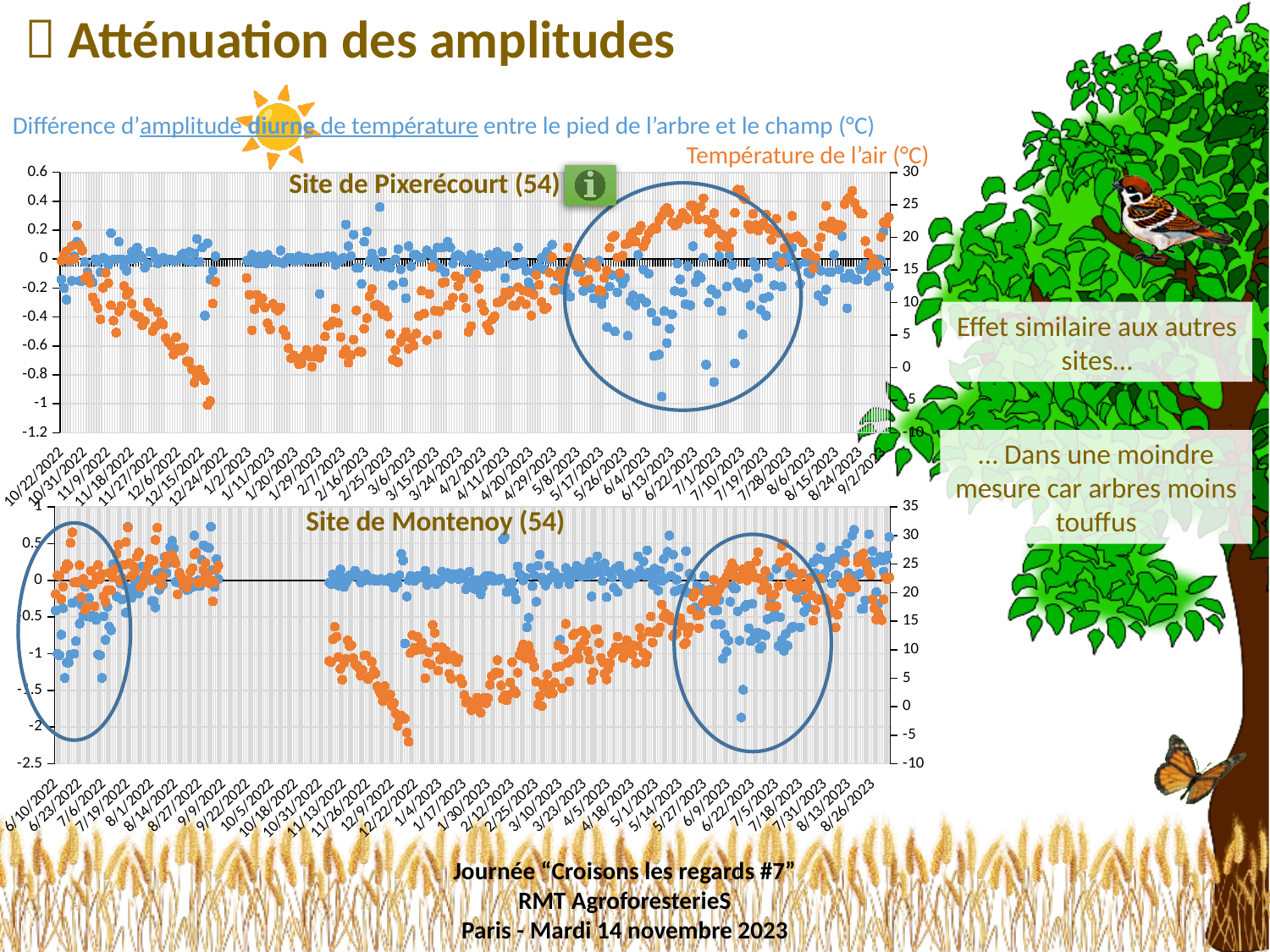
In the "Site de Pixerécourt (54)" chart, are the blue amplitude-difference values around 6/22/2023 mostly greater or less than 0? less What is the title of the bottom chart? Site de Montenoy (54) In the "Site de Montenoy (54)" chart, how many data series are plotted? 2 In the "Site de Pixerécourt (54)" chart, does the air temperature (orange) rise or fall from February 2023 to July 2023? rise How many charts are shown on the slide? 2 What kind of chart is "Site de Pixerécourt (54)"? scatter chart In the "Site de Pixerécourt (54)" chart, how many data series are plotted? 2 What is the title of the top chart? Site de Pixerécourt (54)